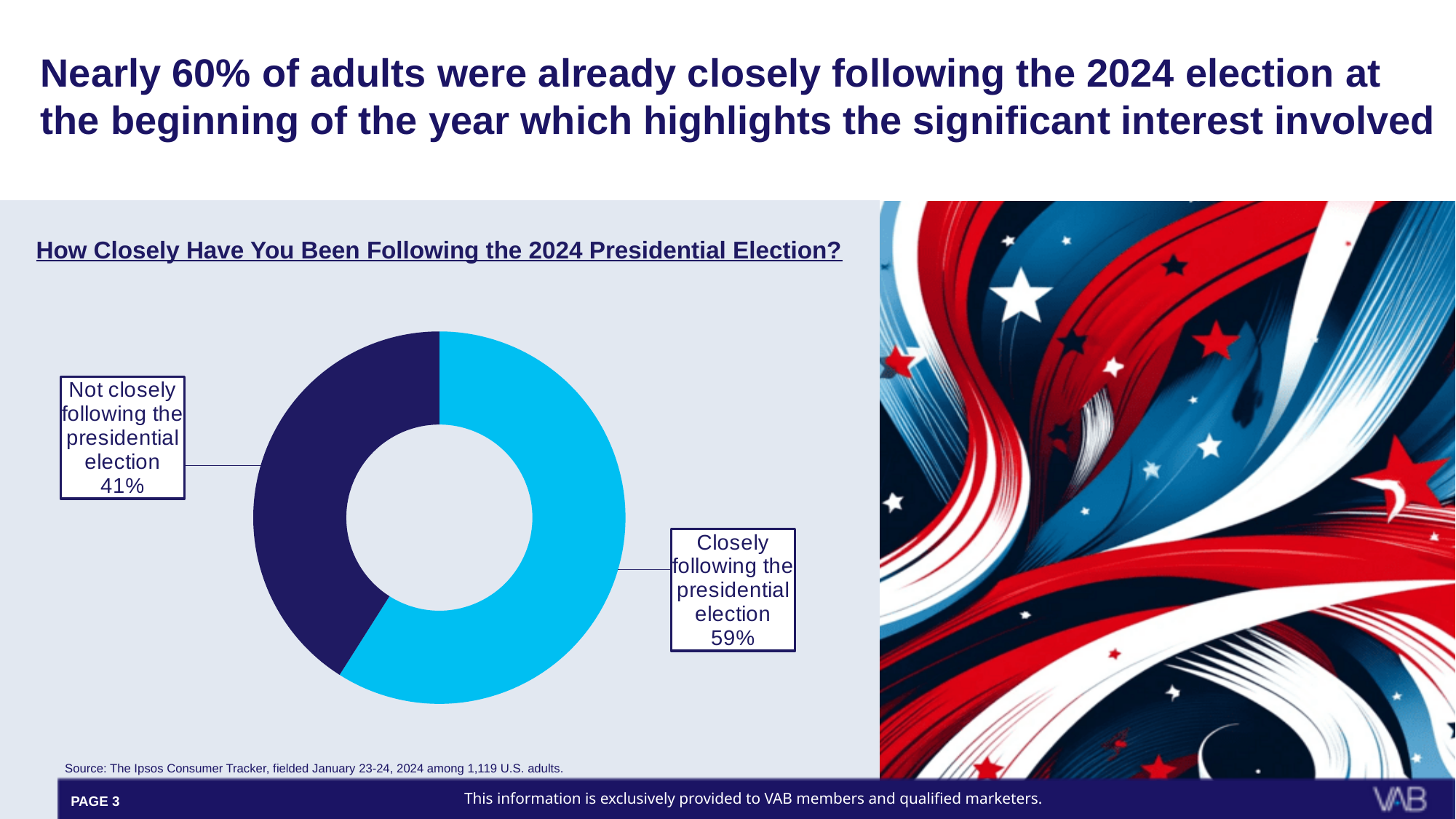
Is the share for closely following the presidential election larger or smaller than the share for not closely following? larger What kind of chart is shown on the slide? Doughnut (pie) chart What percentage of adults are closely following the presidential election? 59% Which category has the larger share of the chart? Closely following the presidential election What is the difference in percentage points between those closely following and those not closely following the election? 18 Which category has the smaller share of the chart? Not closely following the presidential election How many categories does the chart show? 2 What colour is the slice for closely following the presidential election? Light blue What is the total of the two percentages shown in the chart? 100% What is the title of the chart? How Closely Have You Been Following the 2024 Presidential Election? What percentage of adults are not closely following the presidential election? 41%